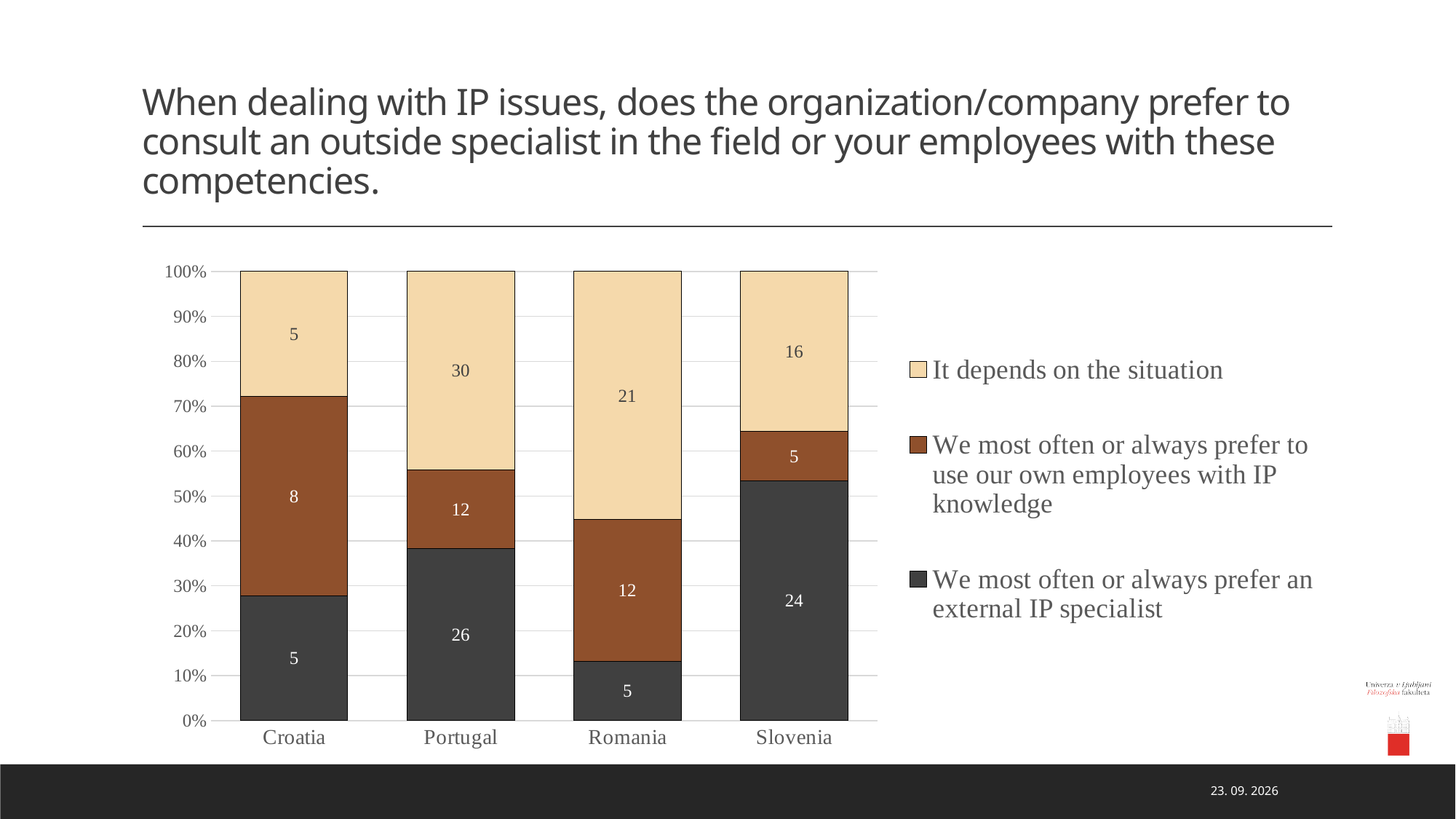
Which series is shown in the darkest colour? We most often or always prefer an external IP specialist How many countries are shown on the x axis? 4 What is the total of the three values in the Romania bar? 38 What is the value for 'We most often or always prefer an external IP specialist' for Slovenia? 24 What is the difference between the 'It depends on the situation' values for Portugal and Romania? 9 How many series does the legend list? 3 Which country has the highest value for 'It depends on the situation'? Portugal Which is larger: the 'We most often or always prefer an external IP specialist' value for Portugal or for Slovenia? Portugal What is the value for 'It depends on the situation' for Portugal? 30 Which country has the lowest value for 'We most often or always prefer to use our own employees with IP knowledge'? Slovenia What is the value for 'We most often or always prefer to use our own employees with IP knowledge' for Croatia? 8 What kind of chart is shown on the slide? Stacked bar chart